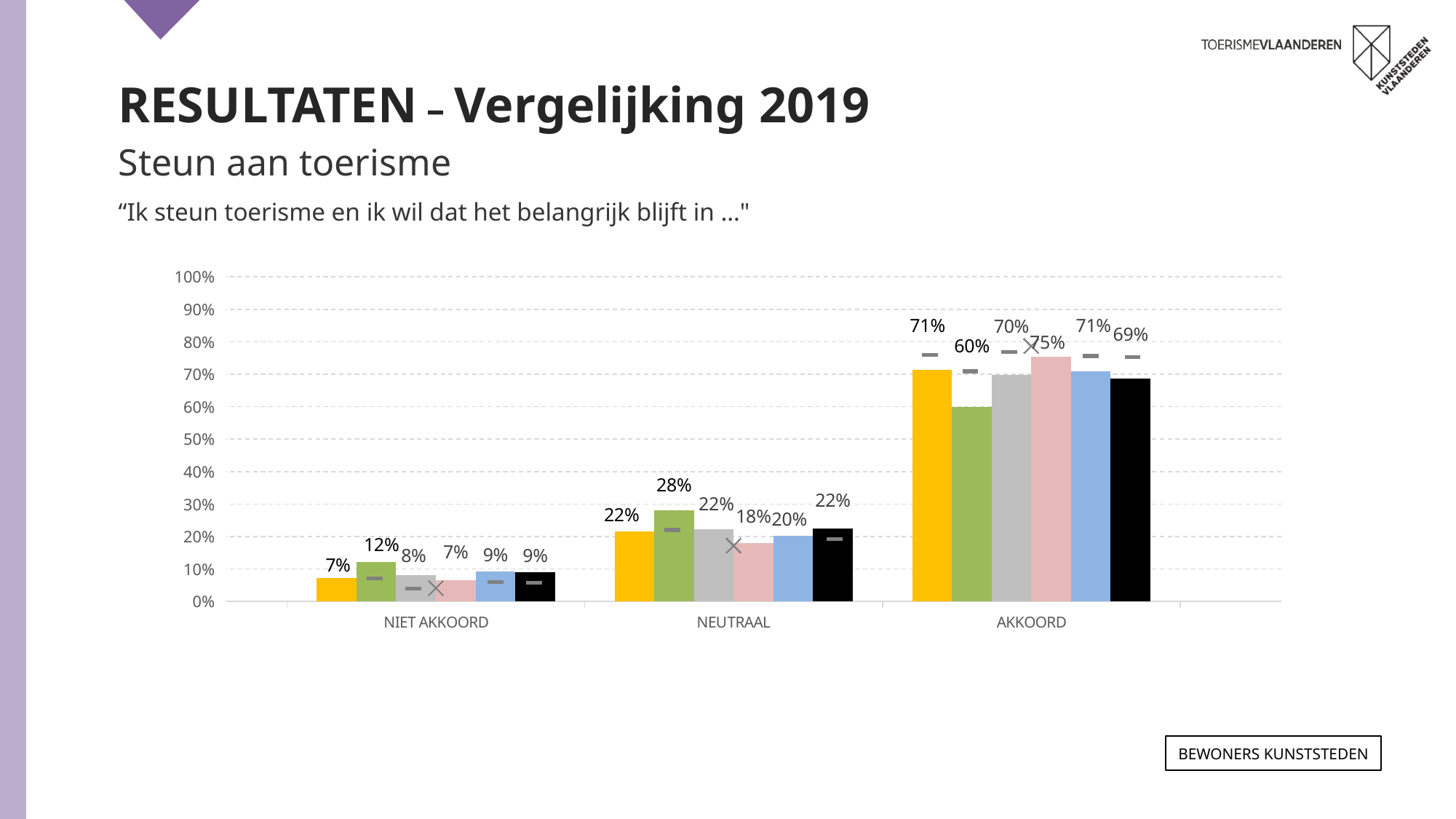
Which bar is the lowest in the AKKOORD category? the green bar (60%) What is the value of the black bar in the NIET AKKOORD category? 9% Which bar is the highest in the AKKOORD category? the pink bar (75%) How many categories are shown on the x axis of the chart? 3 What is the value of the pink bar in the AKKOORD category? 75% In the NEUTRAAL category, which is larger: the green bar or the pink bar? the green bar What is the difference between the pink bar and the green bar in the AKKOORD category? 15% What is the title of the slide? RESULTATEN – Vergelijking 2019 What is the value of the green bar in the NEUTRAAL category? 28% What kind of chart is shown on the slide? bar chart How many bars are plotted in each category of the chart? 6 What is the value of the yellow bar in the AKKOORD category? 71%